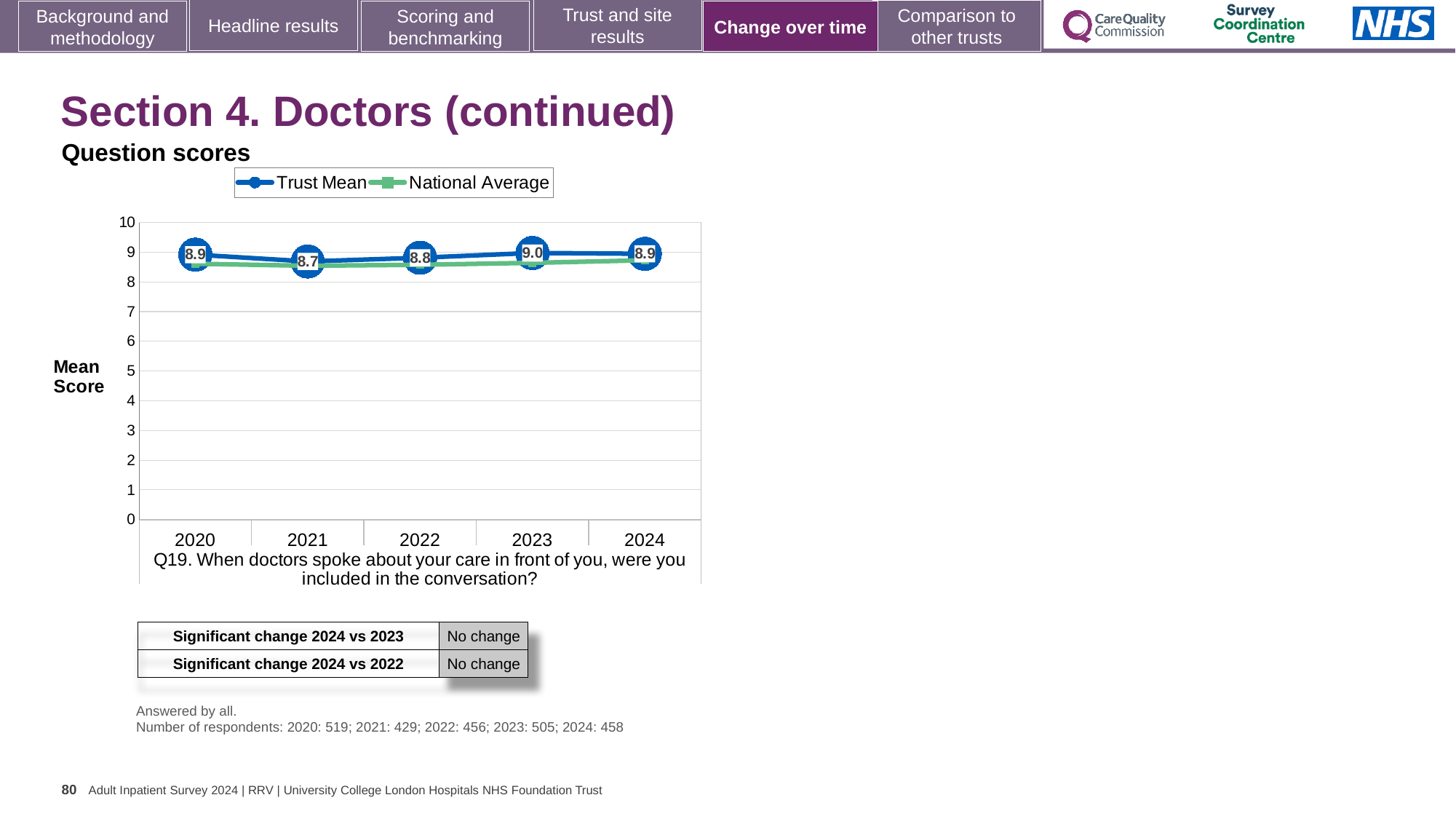
How many years are shown on the x axis? 5 Is the National Average for 2021 greater or less than 8? greater Which is larger, the Trust Mean score for 2022 or for 2023? 2023 What is the difference between the Trust Mean scores for 2023 and 2021? 0.3 What is the label on the y axis? Mean Score In which year is the Trust Mean score lowest? 2021 What is the Trust Mean score for 2024? 8.9 What is the Trust Mean score for 2021? 8.7 What kind of chart is shown? Line chart In which year is the Trust Mean score highest? 2023 What is the Trust Mean score for 2023? 9.0 How many series does the legend list? 2